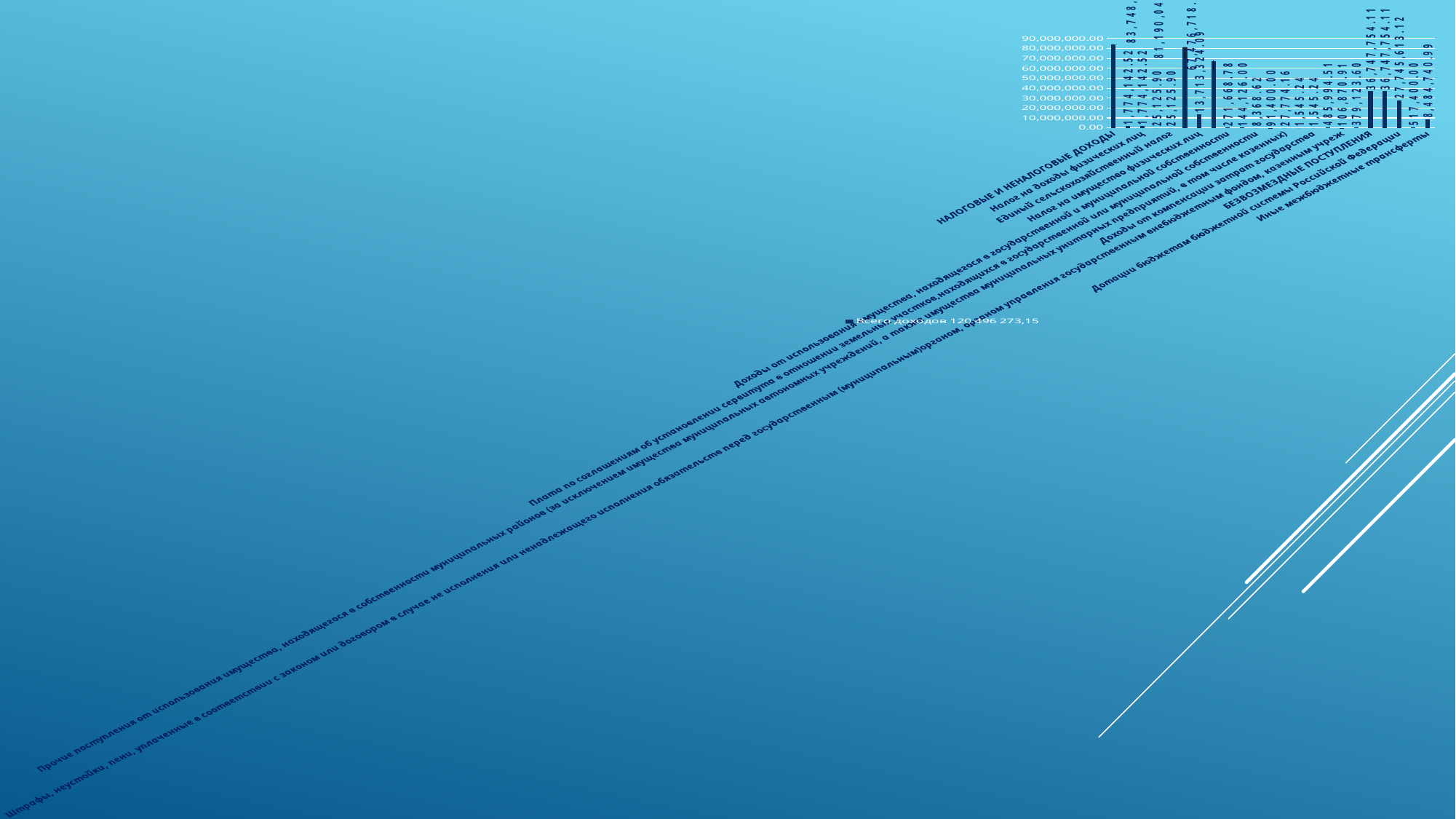
Which category has the highest bar on the chart? НАЛОГОВЫЕ И НЕНАЛОГОВЫЕ ДОХОДЫ What kind of chart is shown on the slide? bar chart Is the value for Иные межбюджетные трансферты greater or less than 10,000,000.00? less What is the value for БЕЗВОЗМЕЗДНЫЕ ПОСТУПЛЕНИЯ? 36,747,754.11 Is the value for БЕЗВОЗМЕЗДНЫЕ ПОСТУПЛЕНИЯ greater or less than 30,000,000.00? greater What is the highest value shown on the chart's vertical axis? 90,000,000.00 What is the legend entry of the chart? Всего доходов 120 496 273,15 Which is larger: the value for БЕЗВОЗМЕЗДНЫЕ ПОСТУПЛЕНИЯ or the value for Дотации бюджетам бюджетной системы Российской Федерации? БЕЗВОЗМЕЗДНЫЕ ПОСТУПЛЕНИЯ What is the value for Налог на доходы физических лиц? 1,774,142.52 What is the value for Иные межбюджетные трансферты? 8,484,740.99 Is the value for НАЛОГОВЫЕ И НЕНАЛОГОВЫЕ ДОХОДЫ greater or less than 70,000,000.00? greater How many series does the chart legend list? 1